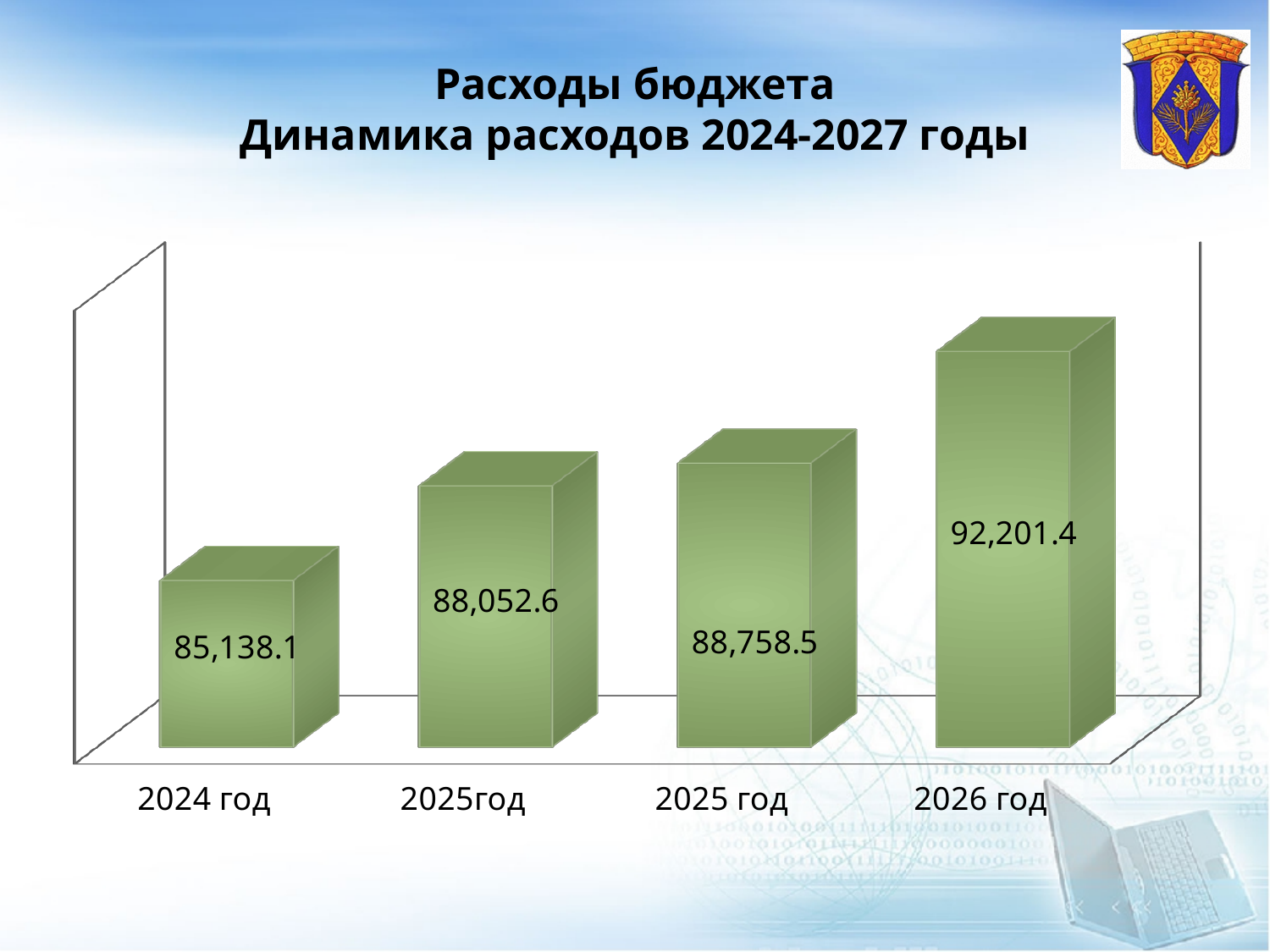
What is the difference between the value for 2026 год and the value for 2024 год? 7,063.3 How many bars are shown in the chart? 4 What is the value shown on the third bar from the left? 88,758.5 Which is larger, the value for 2024 год or the value for 2026 год? 2026 год Which category has the highest value? 2026 год Do the values rise or fall from left to right along the x axis? Rise What is the value shown on the second bar from the left? 88,052.6 What is the difference between the third bar from the left and the second bar from the left? 705.9 What is the value shown for 2026 год? 92,201.4 What kind of chart is shown on the slide? Bar chart What is the value shown for 2024 год? 85,138.1 Which category has the lowest value? 2024 год